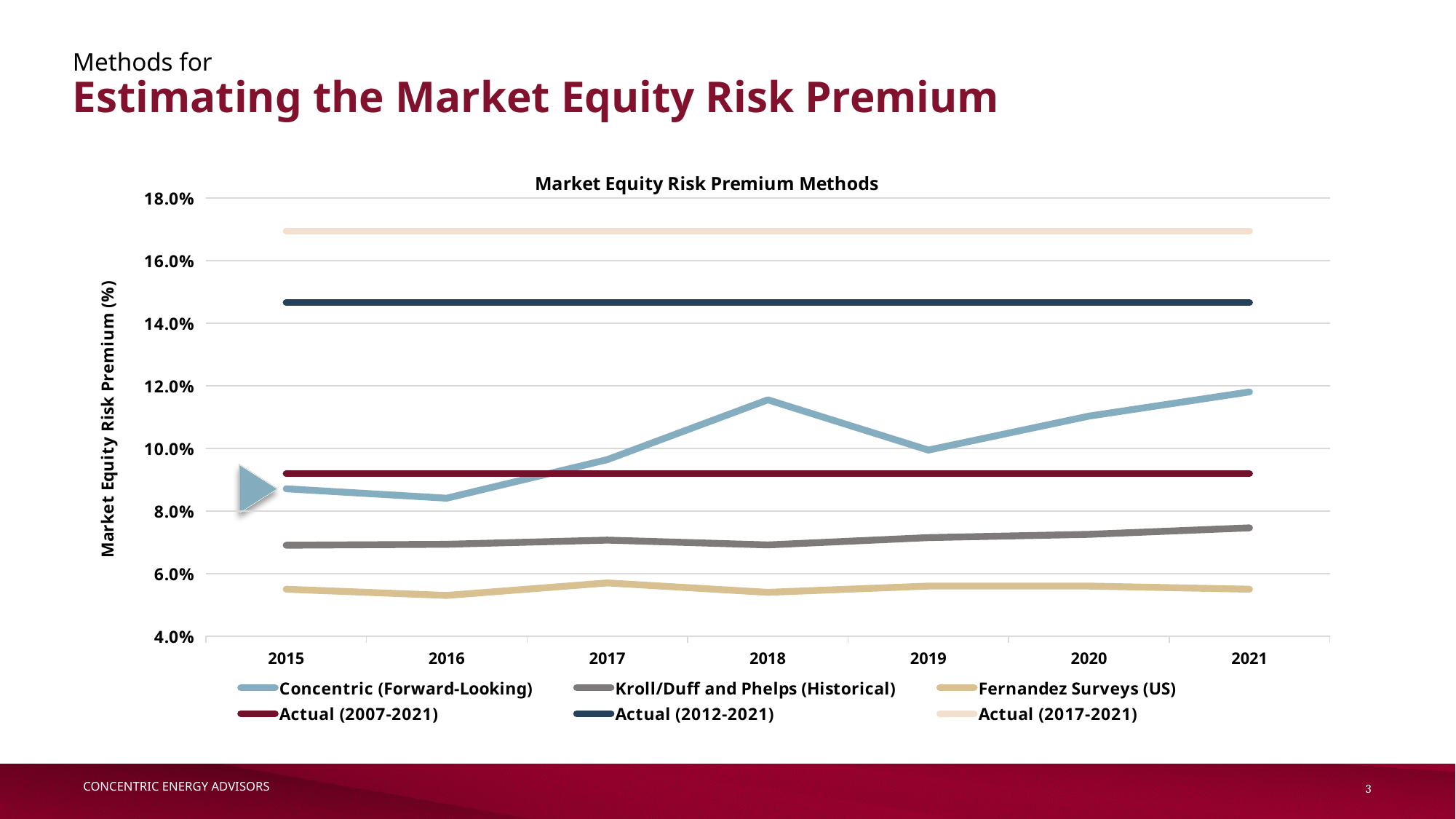
Is the value for Actual (2012-2021) greater or less than 14.0%? greater Which series has the highest values across the chart? Actual (2017-2021) How many series does the legend list? 6 Does the Concentric (Forward-Looking) series rise or fall overall from 2015 to 2021? rise What is the title of the chart? Market Equity Risk Premium Methods Is the value for Fernandez Surveys (US) in 2017 greater or less than 6.0%? less What kind of chart is shown on the slide? line chart Is the value for Actual (2017-2021) greater or less than 16.0%? greater Which is larger for Concentric (Forward-Looking): the value in 2018 or the value in 2019? 2018 How many years are shown on the x axis? 7 Which series has the lowest values across the chart? Fernandez Surveys (US)